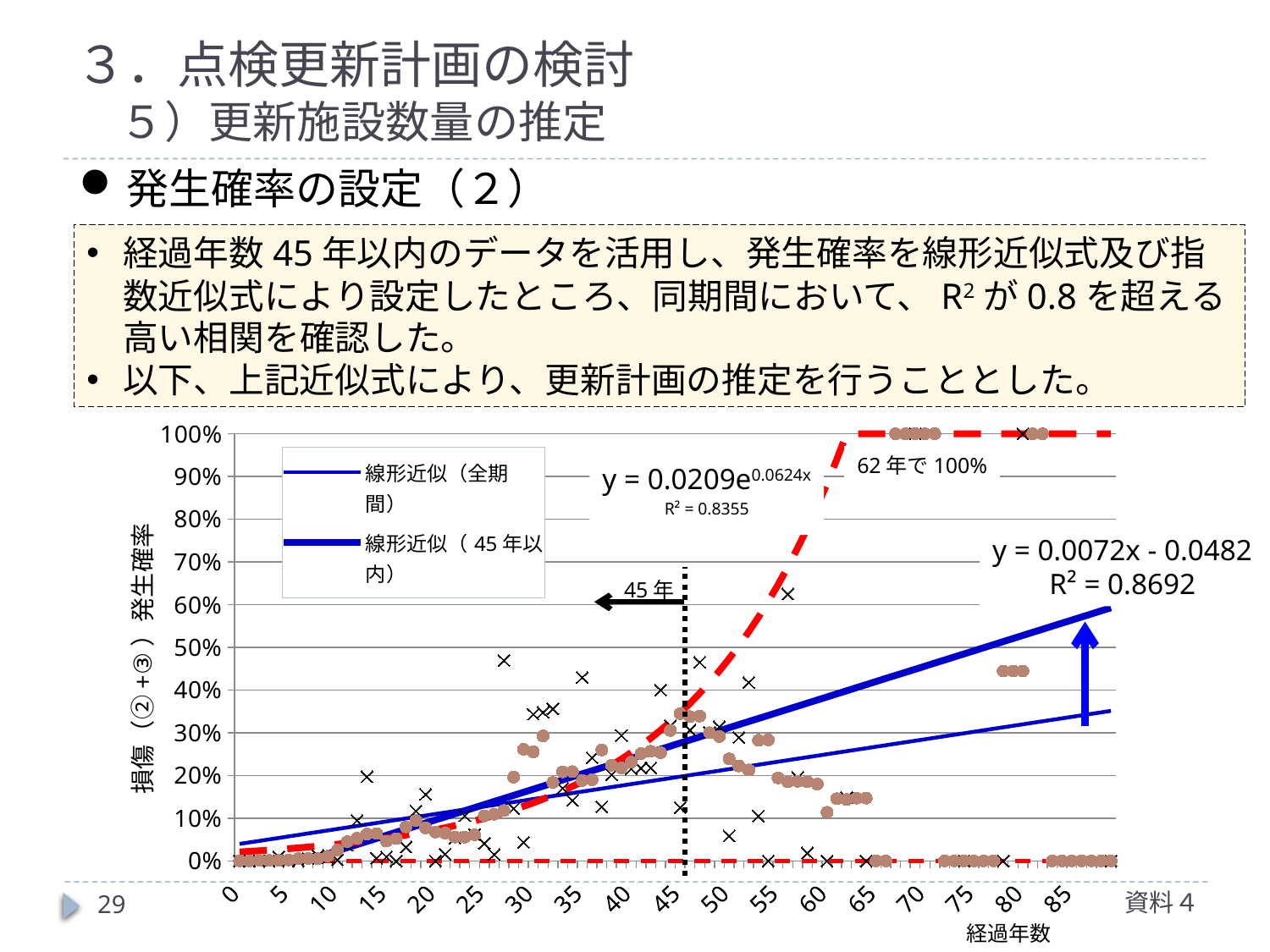
At what number of years is the vertical dotted line on the chart placed? 45年 Does the thick blue linear approximation line rise or fall as 経過年数 increases? rise What is the label of the chart's x axis? 経過年数 According to the annotation on the chart, at how many years does the dashed red line reach 100%? 62年 What is the second legend entry of the chart? 線形近似（45年以内） What is the difference between the two R² values shown on the chart? 0.0337 What is the R² value shown for the linear approximation y = 0.0072x - 0.0482? R² = 0.8692 What is the highest value shown on the chart's y axis? 100% How many series does the chart's legend list? 2 What is the R² value shown for the exponential approximation y = 0.0209e^0.0624x? R² = 0.8355 Which approximation has the higher R² value, the exponential one or the linear one? the linear one (R² = 0.8692) What kind of chart is shown on the slide? line chart